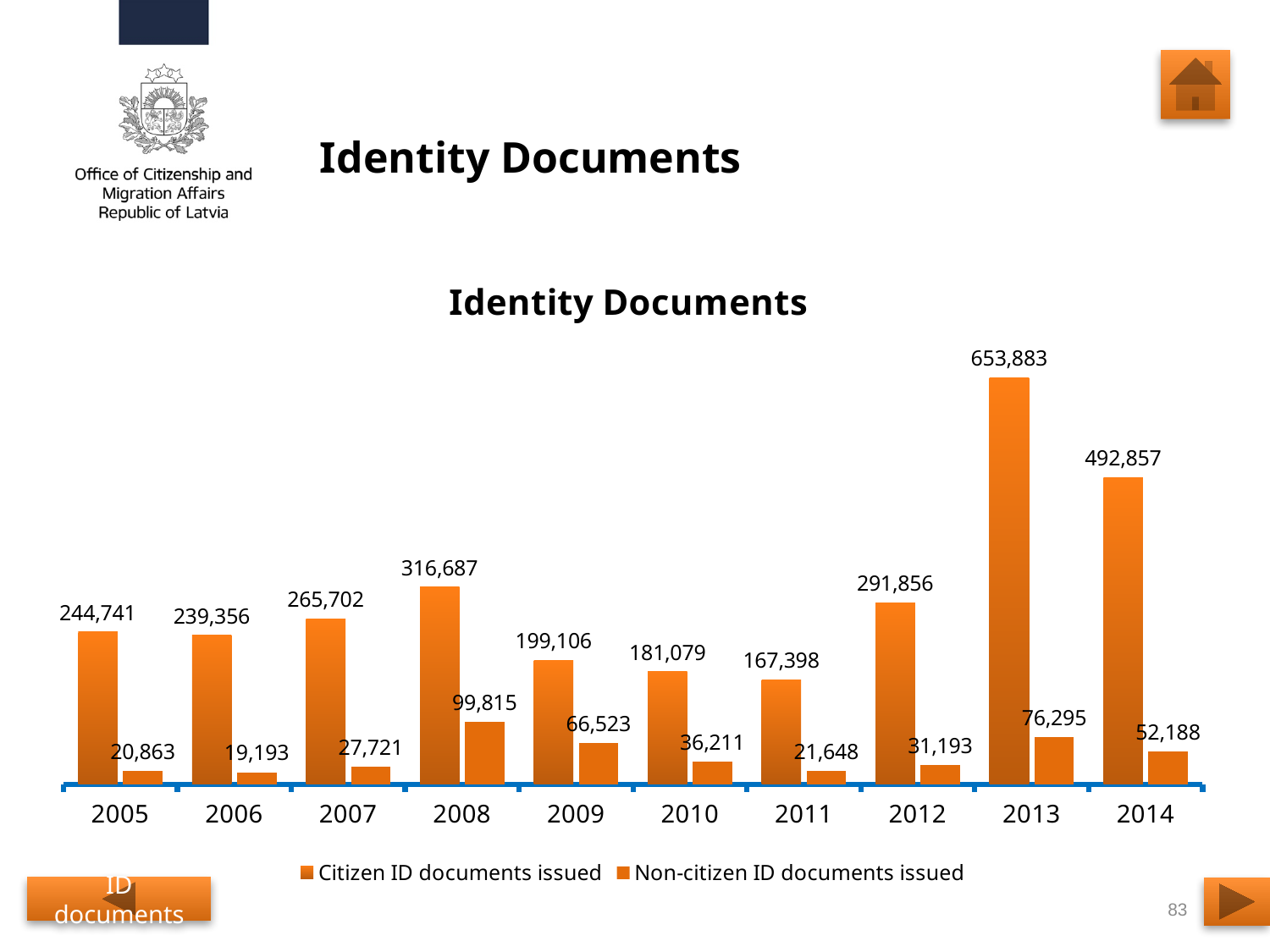
What is the difference between Citizen ID documents issued in 2013 and in 2014? 161,026 What is the value for Citizen ID documents issued in 2010? 181,079 How many years are shown on the x axis of the chart? 10 Do the Citizen ID documents issued values rise or fall from 2008 to 2011? Fall In which year were the most Citizen ID documents issued? 2013 How many Citizen ID documents were issued in 2013? 653,883 How many Non-citizen ID documents were issued in 2008? 99,815 Which year had more Citizen ID documents issued, 2008 or 2012? 2008 In which year were the fewest Non-citizen ID documents issued? 2006 What kind of chart is shown on the slide? Bar chart What is the difference between Non-citizen ID documents issued in 2008 and in 2009? 33,292 How many series does the legend list? 2